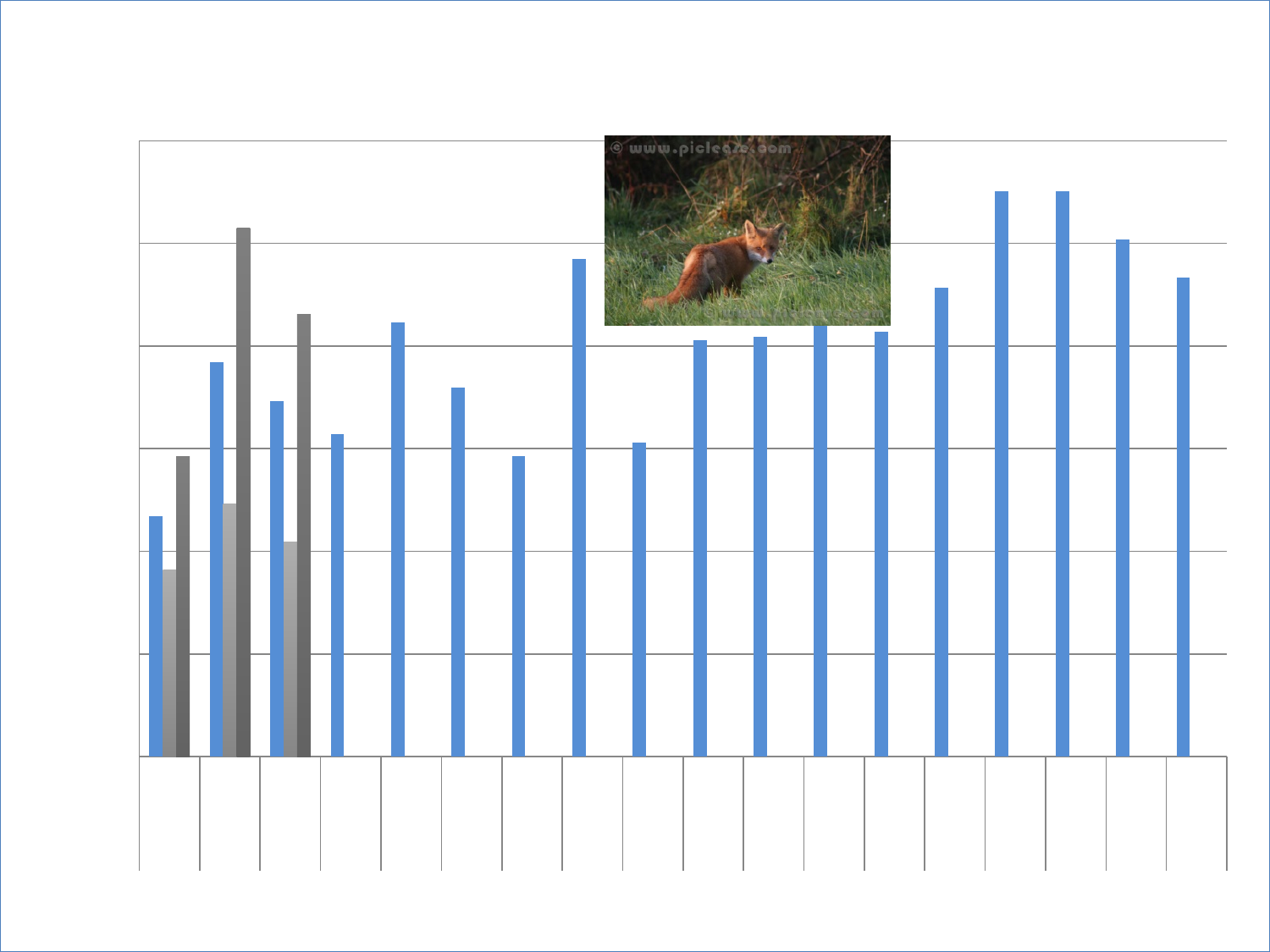
How many categories in the chart have gray bars alongside the blue bar? 3 How many blue bars are plotted in the chart? 18 What animal is shown in the photo placed over the chart? a fox What kind of chart is shown on the slide? bar chart How many different bar colours appear in the chart? 3 Do the blue bars generally rise or fall from left to right along the x axis? rise